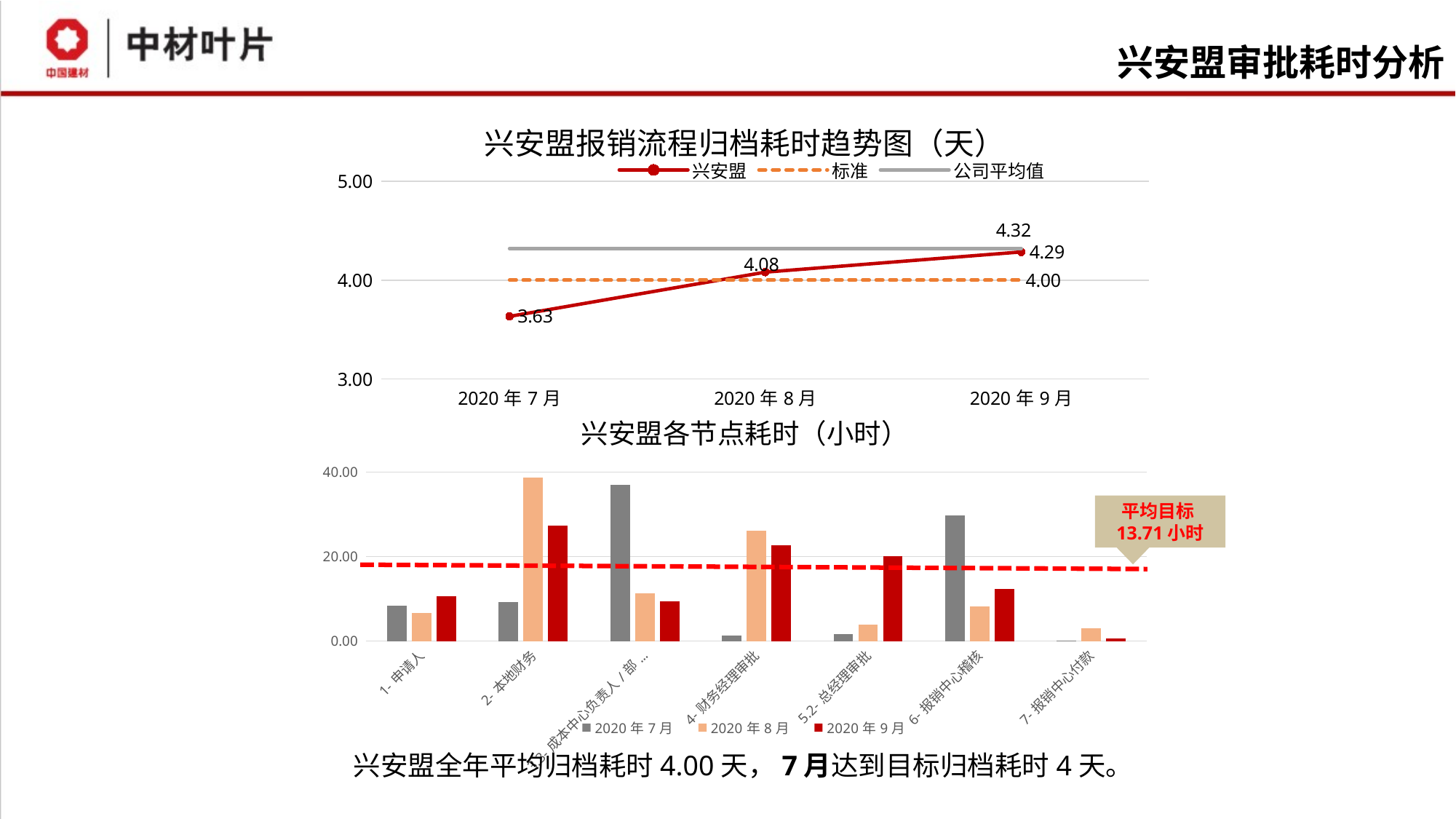
In the bottom chart (兴安盟各节点耗时（小时）), is the 2020年8月 value for 2-本地财务 greater or less than 20.00? greater In the top chart (兴安盟报销流程归档耗时趋势图), which month has the lowest 兴安盟 value? 2020年7月 In the top chart (兴安盟报销流程归档耗时趋势图), does the 兴安盟 series rise or fall from 2020年7月 to 2020年9月? rise In the top chart (兴安盟报销流程归档耗时趋势图), what is the value of the 公司平均值 line? 4.32 In the top chart (兴安盟报销流程归档耗时趋势图), what is the difference between the 兴安盟 values for 2020年9月 and 2020年7月? 0.66 In the bottom chart (兴安盟各节点耗时（小时）), what kind of chart is it? bar chart In the top chart (兴安盟报销流程归档耗时趋势图), what is the 兴安盟 value for 2020年7月? 3.63 In the bottom chart (兴安盟各节点耗时（小时）), which is larger for 4-财务经理审批: the 2020年7月 value or the 2020年8月 value? 2020年8月 In the top chart (兴安盟报销流程归档耗时趋势图), what is the value of the 标准 line? 4.00 In the top chart (兴安盟报销流程归档耗时趋势图), how many series does the legend list? 3 In the bottom chart (兴安盟各节点耗时（小时）), how many categories are shown on the x axis? 7 In the top chart (兴安盟报销流程归档耗时趋势图), what is the 兴安盟 value for 2020年9月? 4.29